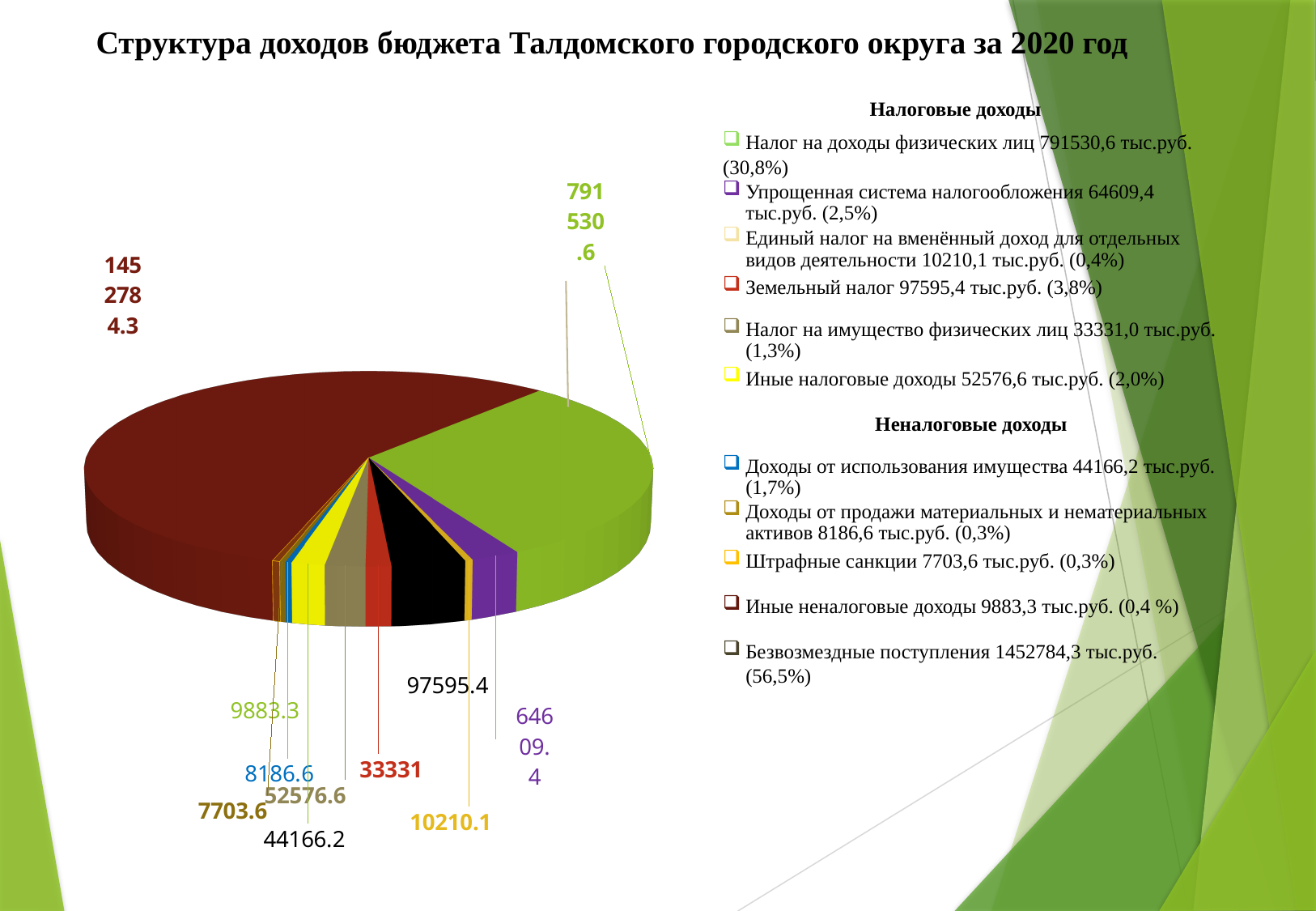
According to the slide, what share of budget revenue is Безвозмездные поступления? 56,5% What kind of chart is shown on the slide? pie chart Which slice is larger, the black slice or the purple slice? the black slice What is the title of the slide? Структура доходов бюджета Талдомского городского округа за 2020 год According to the slide, what share of budget revenue is Налог на доходы физических лиц? 30,8% What is the data label on the smallest slice of the pie chart? 7703.6 What is the data label on the largest slice of the pie chart? 1452784.3 What value is labelled on the black slice of the pie chart? 97595.4 What value is labelled on the green slice of the pie chart? 791530.6 What value is labelled on the dark red slice of the pie chart? 1452784.3 How many slices does the pie chart have? 11 What is the difference between the dark red slice (1452784.3) and the green slice (791530.6)? 661253.7